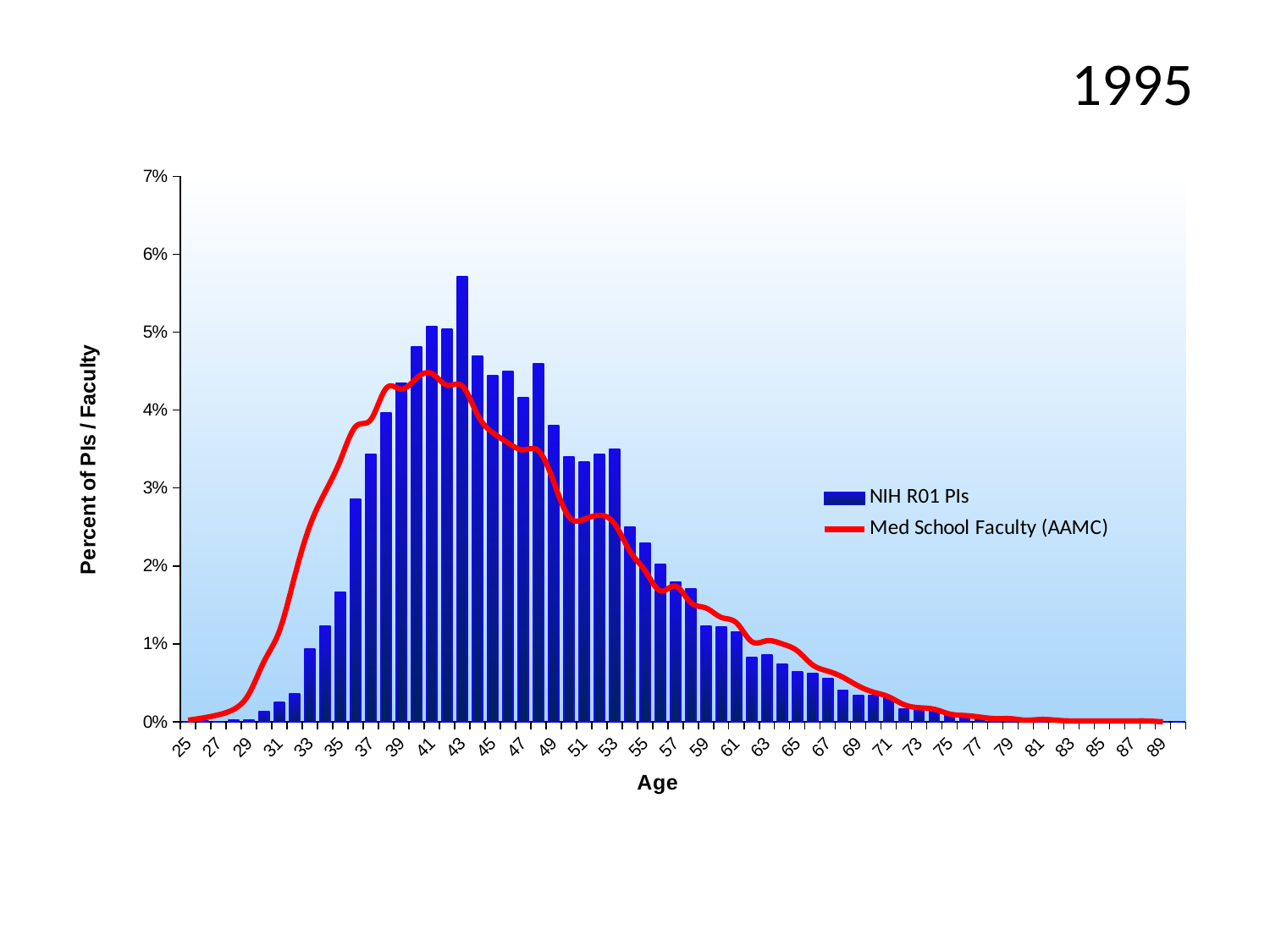
Do the NIH R01 PIs bars generally rise or fall from age 43 to age 89? fall What are the two series named in the legend? NIH R01 PIs; Med School Faculty (AAMC) Is the NIH R01 PIs value at age 37 greater or less than 3%? greater What is the label of the x axis? Age Is the NIH R01 PIs value at age 65 greater or less than 1%? less Is the NIH R01 PIs value at age 49 greater or less than 4%? less Which is larger for NIH R01 PIs: the bar at age 39 or the bar at age 53? age 39 How many series does the legend list? 2 At which age is the NIH R01 PIs bar highest? 43 Which is larger for NIH R01 PIs: the bar at age 35 or the bar at age 59? age 35